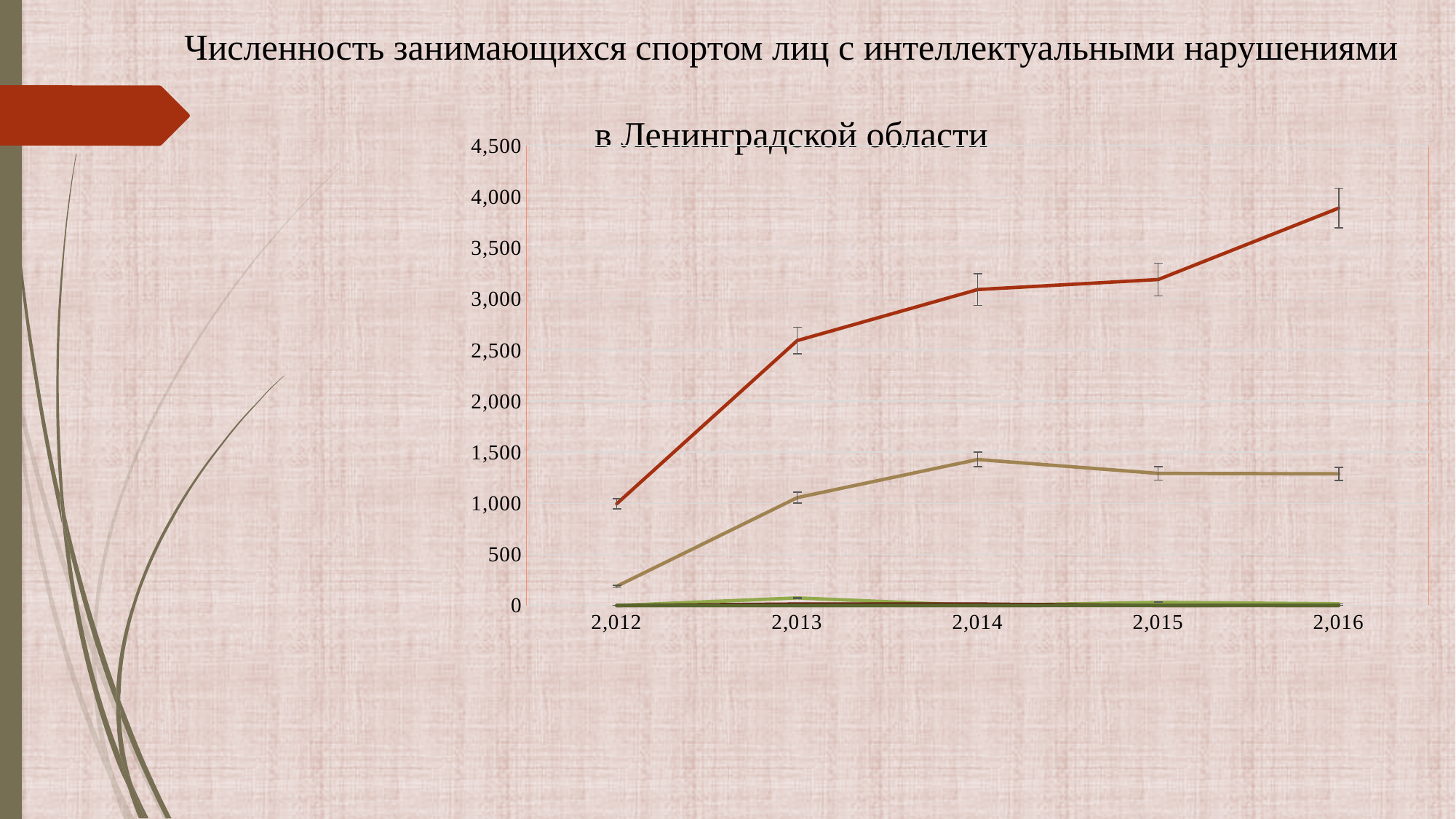
In which year does the red line reach its highest value? 2,016 In which year does the tan (brown) line have its lowest value? 2,012 In which year does the tan (brown) line reach its highest value? 2,014 How many years are plotted along the x axis? 5 What is the title of the chart? Численность занимающихся спортом лиц с интеллектуальными нарушениями в Ленинградской области Does the red line rise or fall from 2,012 to 2,016? rises Is the value of the red line in 2,016 greater or less than 3,500? greater In 2,016, which line has the larger value, the red line or the tan (brown) line? the red line Is the value of the tan (brown) line in 2,012 greater or less than 500? less What kind of chart is shown on the slide? line chart In which year does the red line have its lowest value? 2,012 What is the highest value shown on the y axis? 4,500